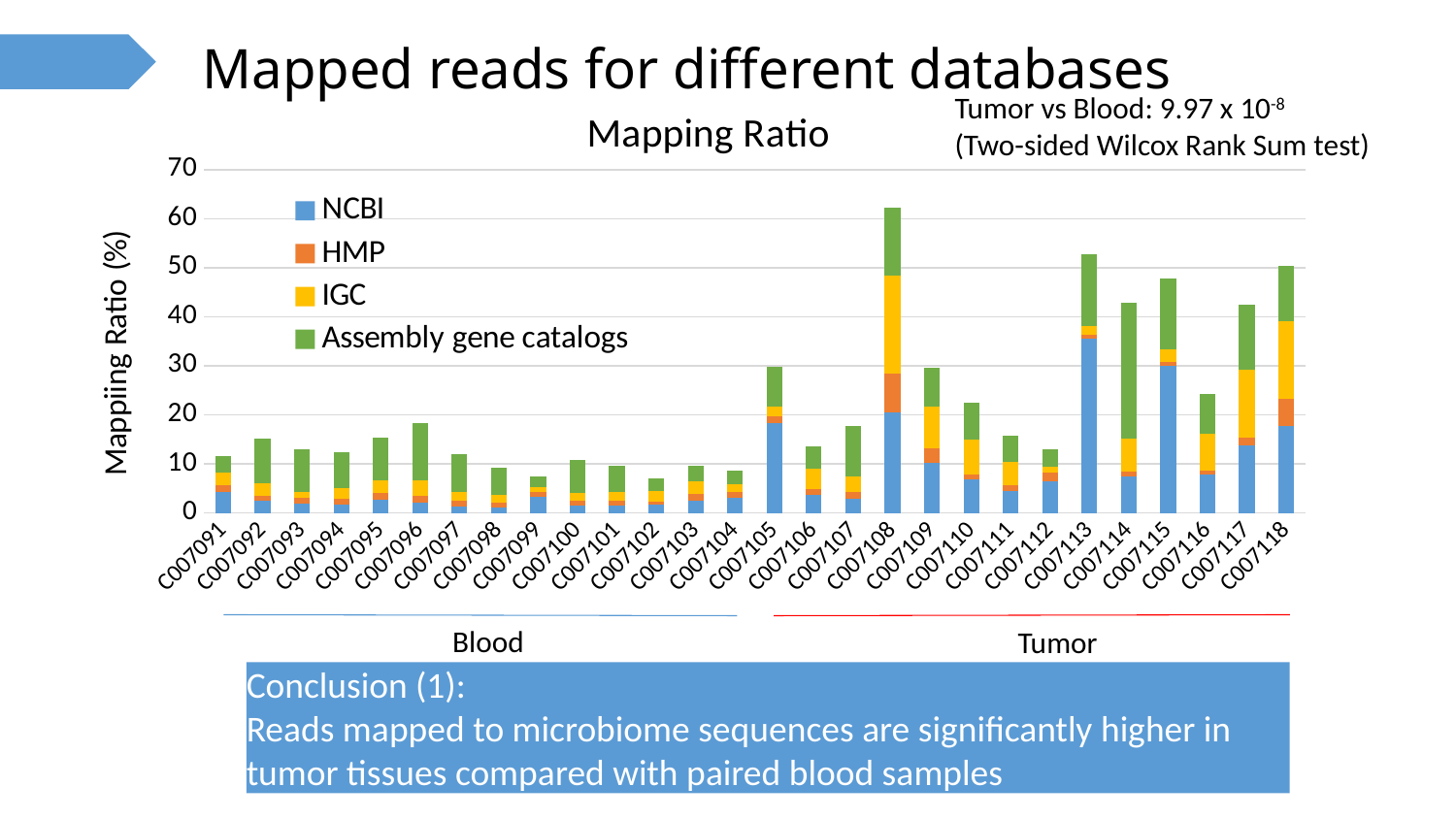
Which has a larger total mapping ratio, C007096 or C007099? C007096 Which has a larger total mapping ratio, C007108 or C007113? C007108 What kind of chart is shown on the slide? Stacked bar chart How many sample categories are plotted along the x axis of the Mapping Ratio chart? 28 How many series does the legend of the Mapping Ratio chart list? 4 Which group of samples, Blood or Tumor, generally shows higher total mapping ratios? Tumor Is the total mapping ratio for C007099 greater or less than 10? less Which series is listed first in the chart legend? NCBI Is the total mapping ratio for C007114 greater or less than 40? greater Is the total mapping ratio for C007108 greater or less than 50? greater Which sample has the highest total mapping ratio in the chart? C007108